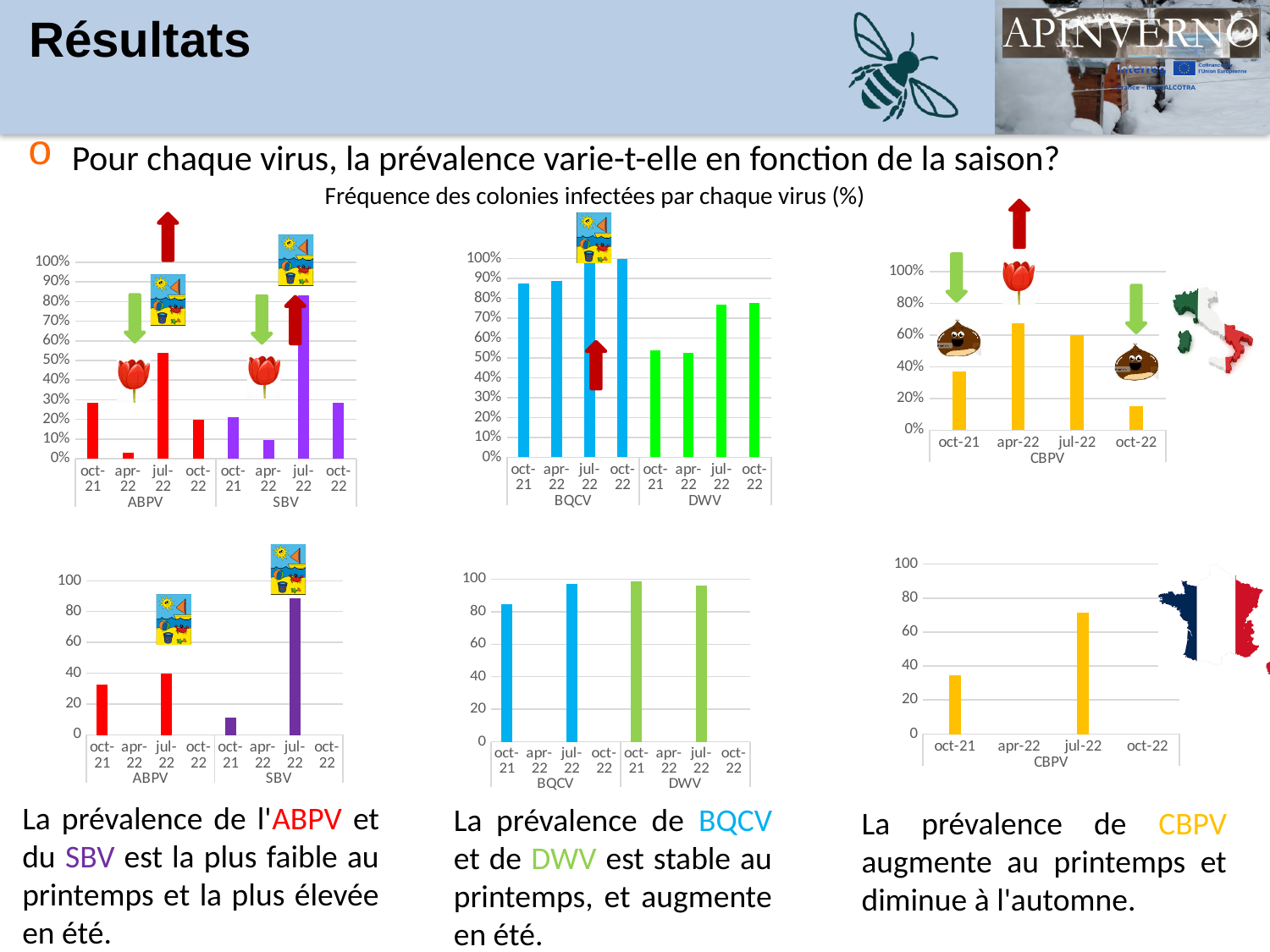
In the top-left chart (ABPV and SBV), which period has the highest value for SBV? jul-22 In the top-right chart (CBPV), which period has the lowest value? oct-22 In the top-left chart (ABPV and SBV), is the value for ABPV in jul-22 greater or less than 50%? greater In the top-left chart (ABPV and SBV), which period has the lowest value for ABPV? apr-22 In the top-right chart (CBPV), which period has the highest value? apr-22 In the top-right chart (CBPV), is the value for oct-22 greater or less than 20%? less In the top-left chart (ABPV and SBV), what kind of chart is shown? bar chart In the top-middle chart (BQCV and DWV), is the value for DWV in oct-21 greater or less than 50%? greater In the bottom-left chart (ABPV and SBV), which is larger: SBV in jul-22 or ABPV in jul-22? SBV in jul-22 In the top-middle chart (BQCV and DWV), which is larger: BQCV in oct-21 or DWV in oct-21? BQCV in oct-21 In the top-right chart (CBPV), how many periods are shown on the x axis? 4